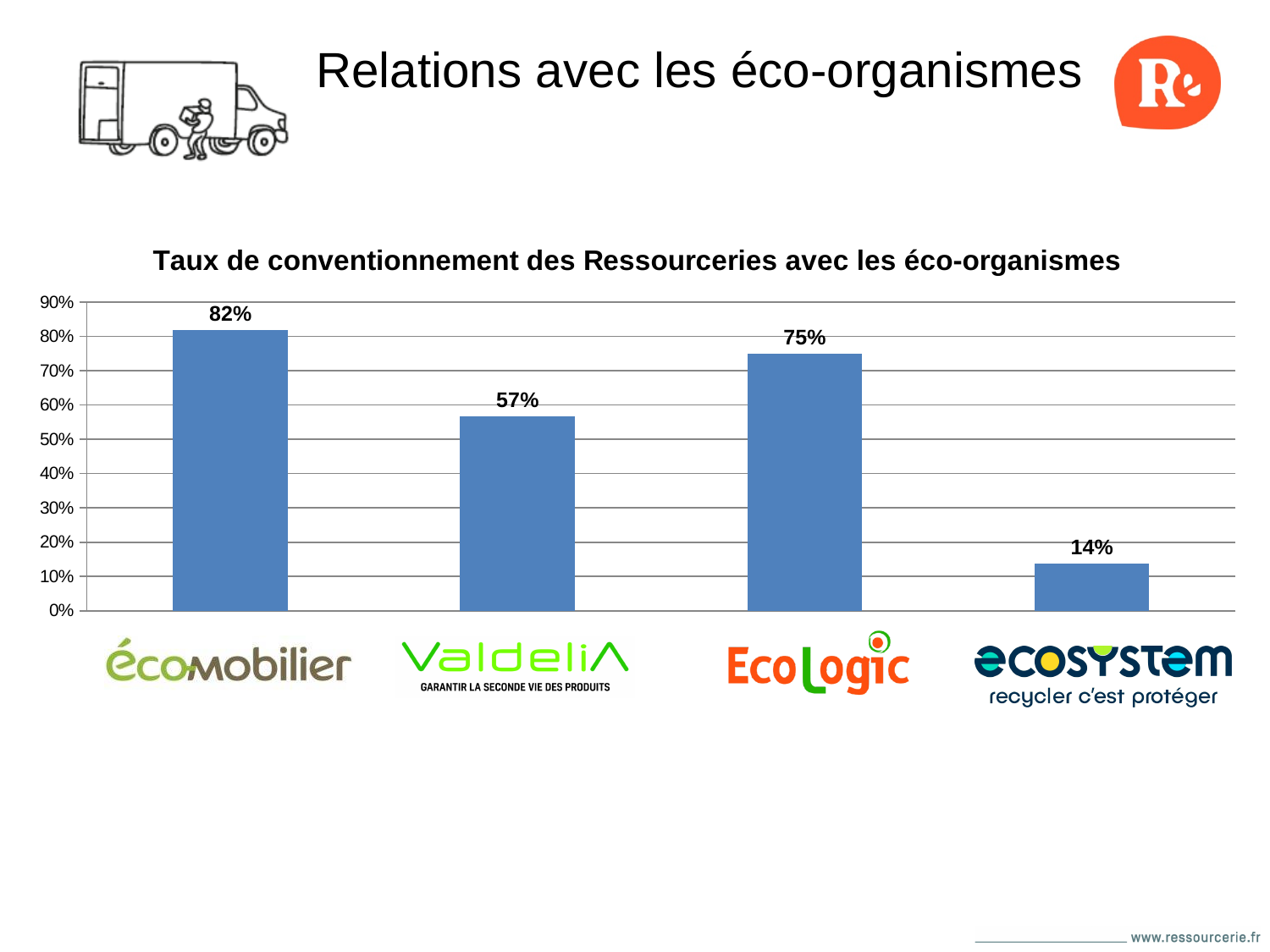
What kind of chart is shown on the slide? Bar chart What is the value for Ecosystem? 14% Which eco-organisme has the lowest conventionnement rate? Ecosystem What is the difference between the values for Ecologic and Valdelia? 18% Which eco-organisme has the highest conventionnement rate? Écomobilier What is the difference between the values for Écomobilier and Ecosystem? 68% Which is larger, the value for Valdelia or the value for Ecologic? Ecologic What is the value for Ecologic? 75% What is the value for Valdelia? 57% What is the value for Écomobilier? 82% What is the title of the chart? Taux de conventionnement des Ressourceries avec les éco-organismes How many eco-organismes are shown in the chart? 4